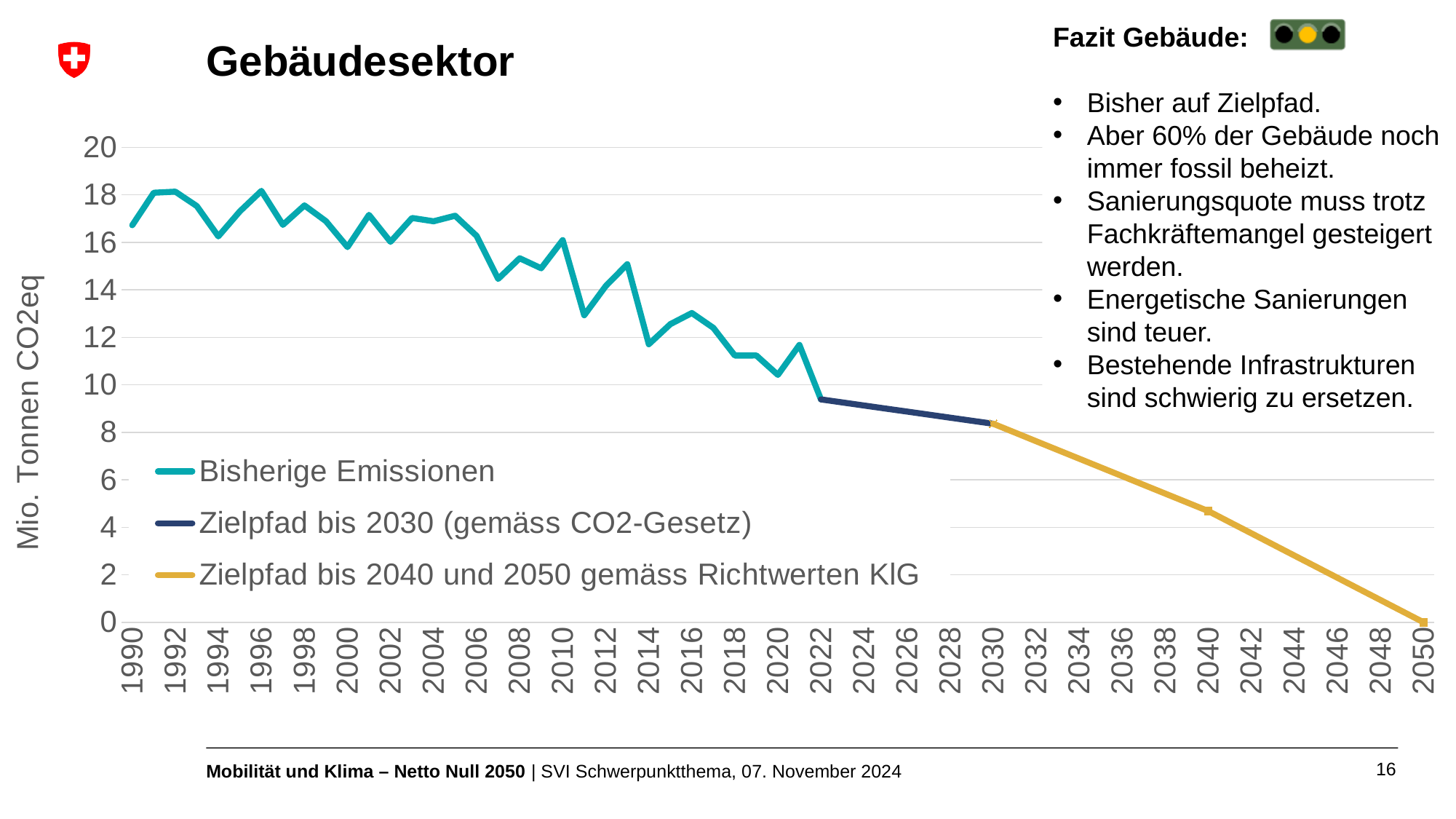
Is the value for 2022 greater or less than 10? less What kind of chart is shown on the slide? line chart What is the title of the chart on the slide? Gebäudesektor Which is larger, the value for 1990 or the value for 2020? 1990 Is the value for 1990 greater or less than 16? greater How many series does the chart legend list? 3 Is the value for 2030 greater or less than 8? greater Which year has the lowest value on the chart? 2050 Do the values generally rise or fall from 1990 to 2050? fall What value does the Zielpfad line reach in 2050? 0 What is the label of the vertical axis? Mio. Tonnen CO2eq